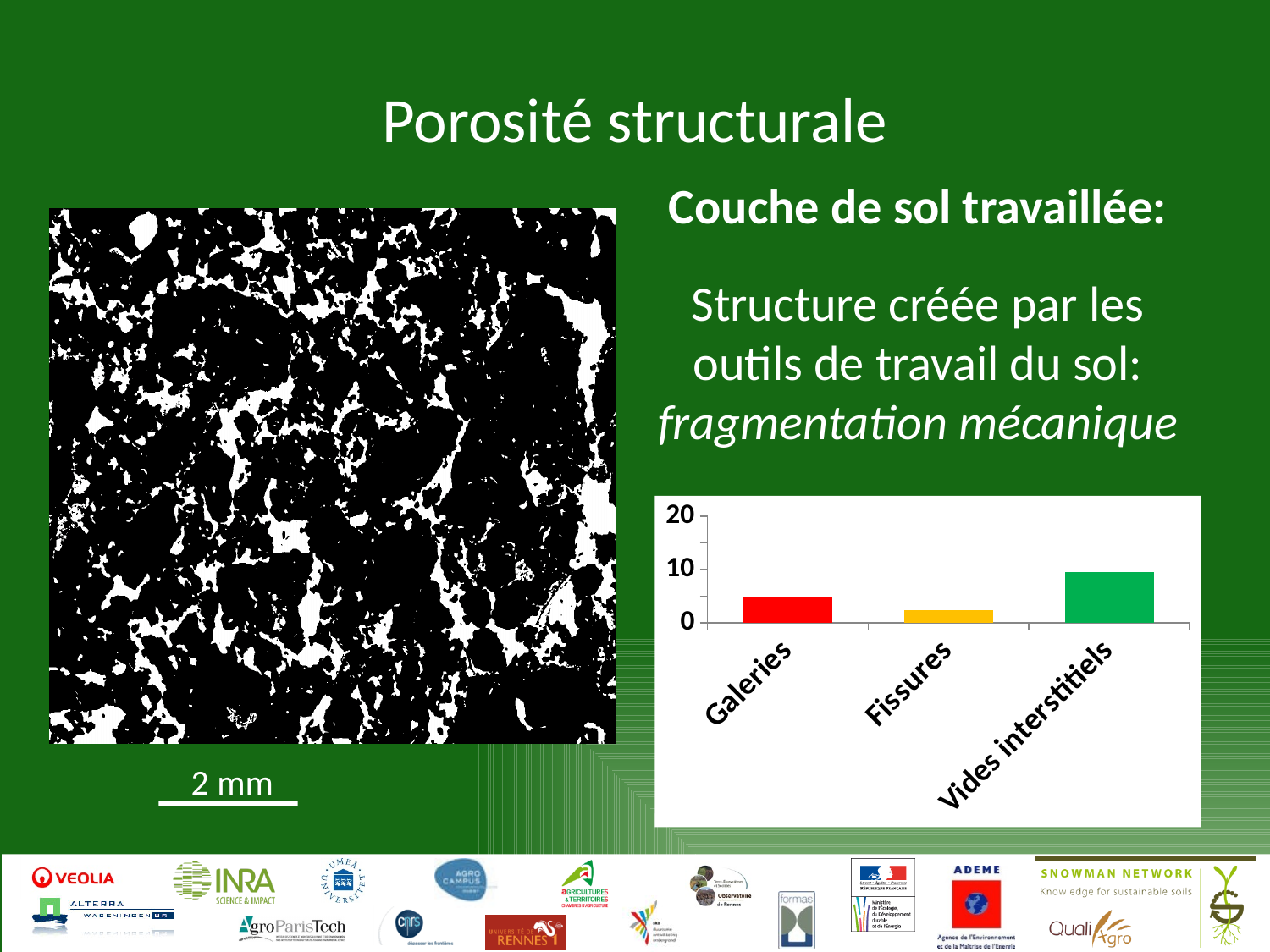
Which is larger in the chart, the value for Vides interstitiels or the value for Galeries? Vides interstitiels Is the value for Galeries greater or less than 10? less Which category has the highest bar in the chart? Vides interstitiels How many categories are shown on the x axis of the bar chart? 3 Is the value for Vides interstitiels greater or less than 20? less What colour is the bar for Vides interstitiels? green What kind of chart is shown on the slide? bar chart Which is larger in the chart, the value for Galeries or the value for Fissures? Galeries Is the value for Fissures greater or less than 10? less Which category has the lowest bar in the chart? Fissures What is the highest tick value shown on the y axis of the chart? 20